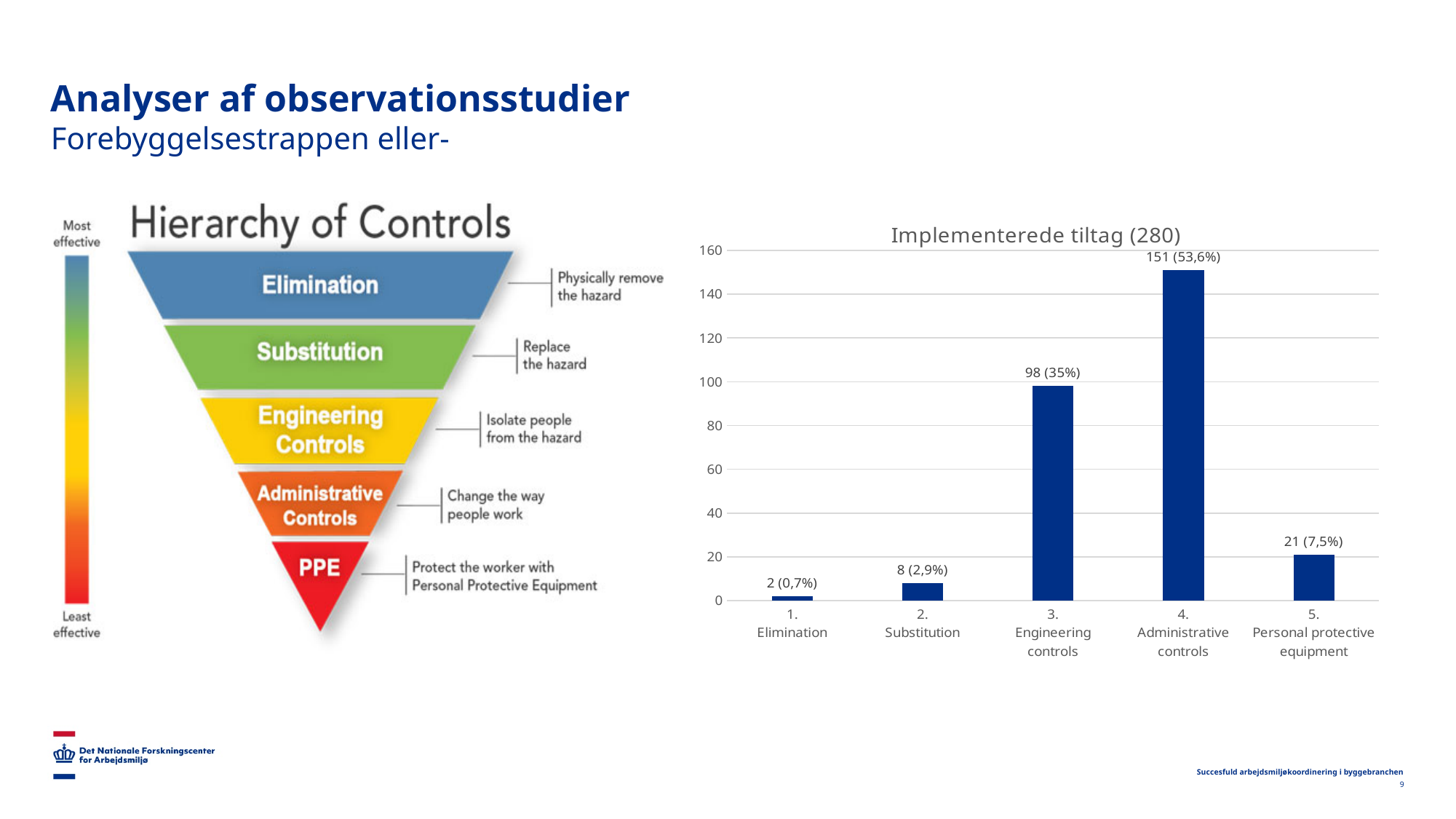
What is the data label for Administrative controls in the 'Implementerede tiltag (280)' chart? 151 (53,6%) What is the data label for Engineering controls in the 'Implementerede tiltag (280)' chart? 98 (35%) Which category has the highest value in the 'Implementerede tiltag (280)' chart? Administrative controls How many categories are shown in the 'Implementerede tiltag (280)' chart? 5 What is the title of the bar chart on the slide? Implementerede tiltag (280) What is the data label for Elimination in the 'Implementerede tiltag (280)' chart? 2 (0,7%) What kind of chart is 'Implementerede tiltag (280)'? bar chart Which category has the lowest value in the 'Implementerede tiltag (280)' chart? Elimination What is the data label for Personal protective equipment in the 'Implementerede tiltag (280)' chart? 21 (7,5%) In the 'Implementerede tiltag (280)' chart, what is the difference between the counts for Administrative controls and Engineering controls? 53 In the 'Implementerede tiltag (280)' chart, is the value for Engineering controls greater or less than 100? less In the 'Implementerede tiltag (280)' chart, which is larger: Substitution or Personal protective equipment? Personal protective equipment